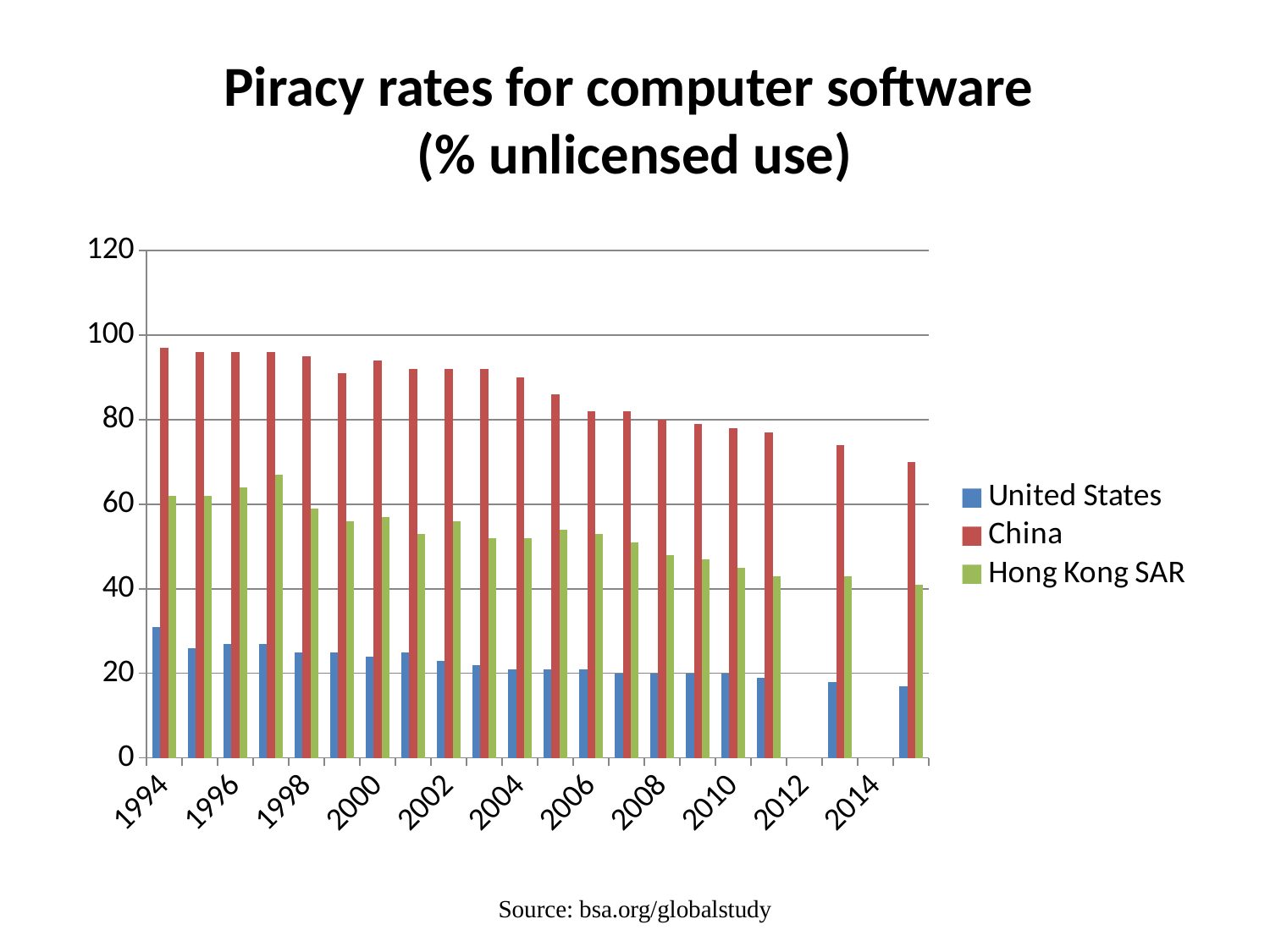
Is the value for the United States in 1994 greater or less than 20? greater Which series has the lowest piracy rate in 2010? United States Which is larger in 2000, the value for China or the value for Hong Kong SAR? China Which series has the highest piracy rate in 1994? China What is the title of the chart? Piracy rates for computer software (% unlicensed use) Which series is shown in red in the legend? China Is the value for China in 1994 greater or less than 80? greater Do the values for China rise or fall from 1994 to 2014 along the x axis? fall What kind of chart is shown on the slide? bar chart How many series does the legend list? 3